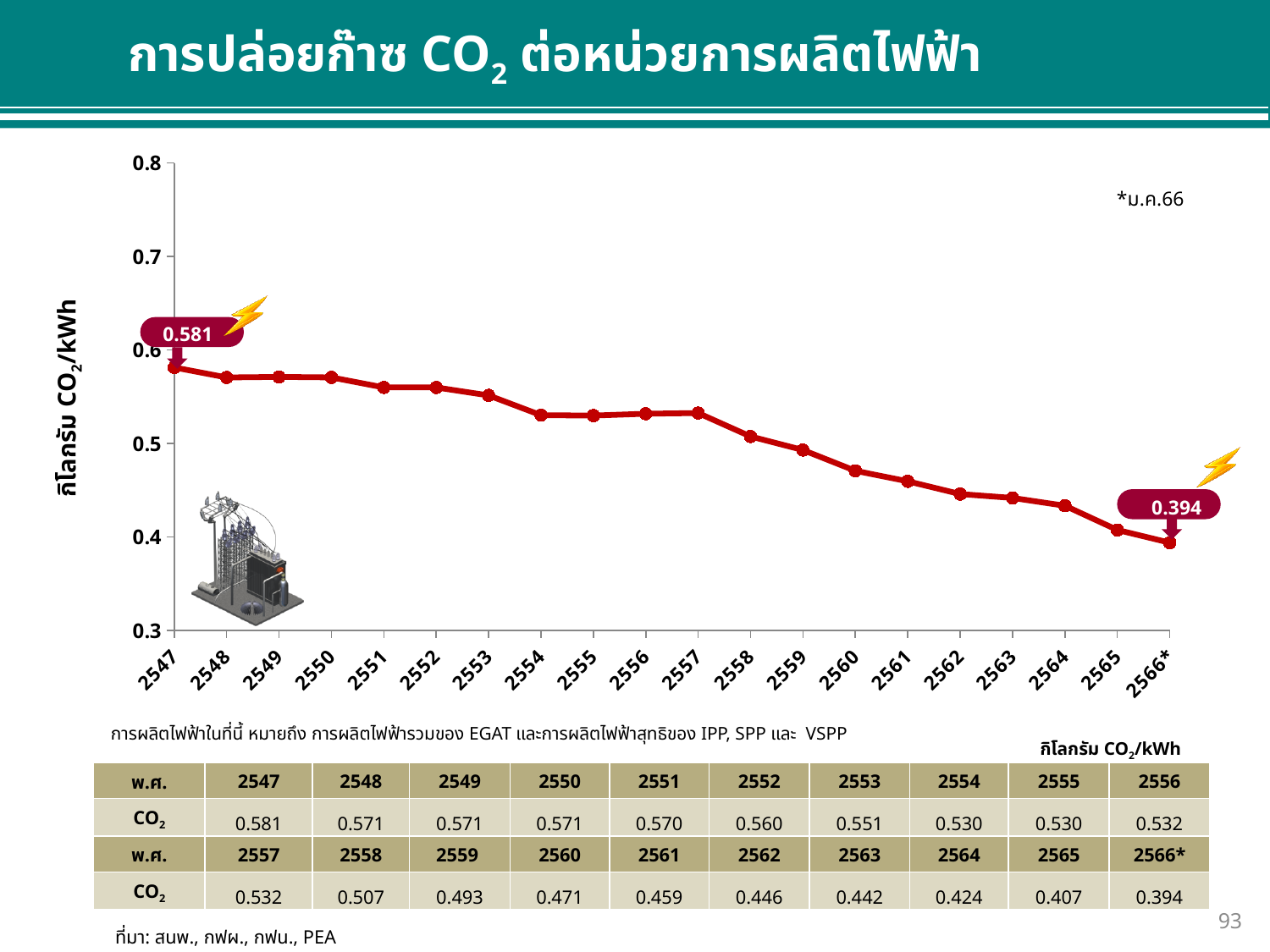
Which year has the highest CO2 emission value? 2547 What type of chart is shown on the slide? line chart Is the CO2 emission value for 2557 greater or less than 0.5? greater What is the CO2 emission value for the year 2566*? 0.394 How many years are plotted on the x axis? 20 What is the difference between the CO2 emission values for 2547 and 2566*? 0.187 Which year has a larger CO2 emission value, 2553 or 2560? 2553 Which year has the lowest CO2 emission value? 2566* What is the CO2 emission value for the year 2558? 0.507 Do the CO2 emission values generally rise or fall from 2547 to 2566*? fall What is the CO2 emission value for the year 2547? 0.581 What is the CO2 emission value for the year 2562? 0.446